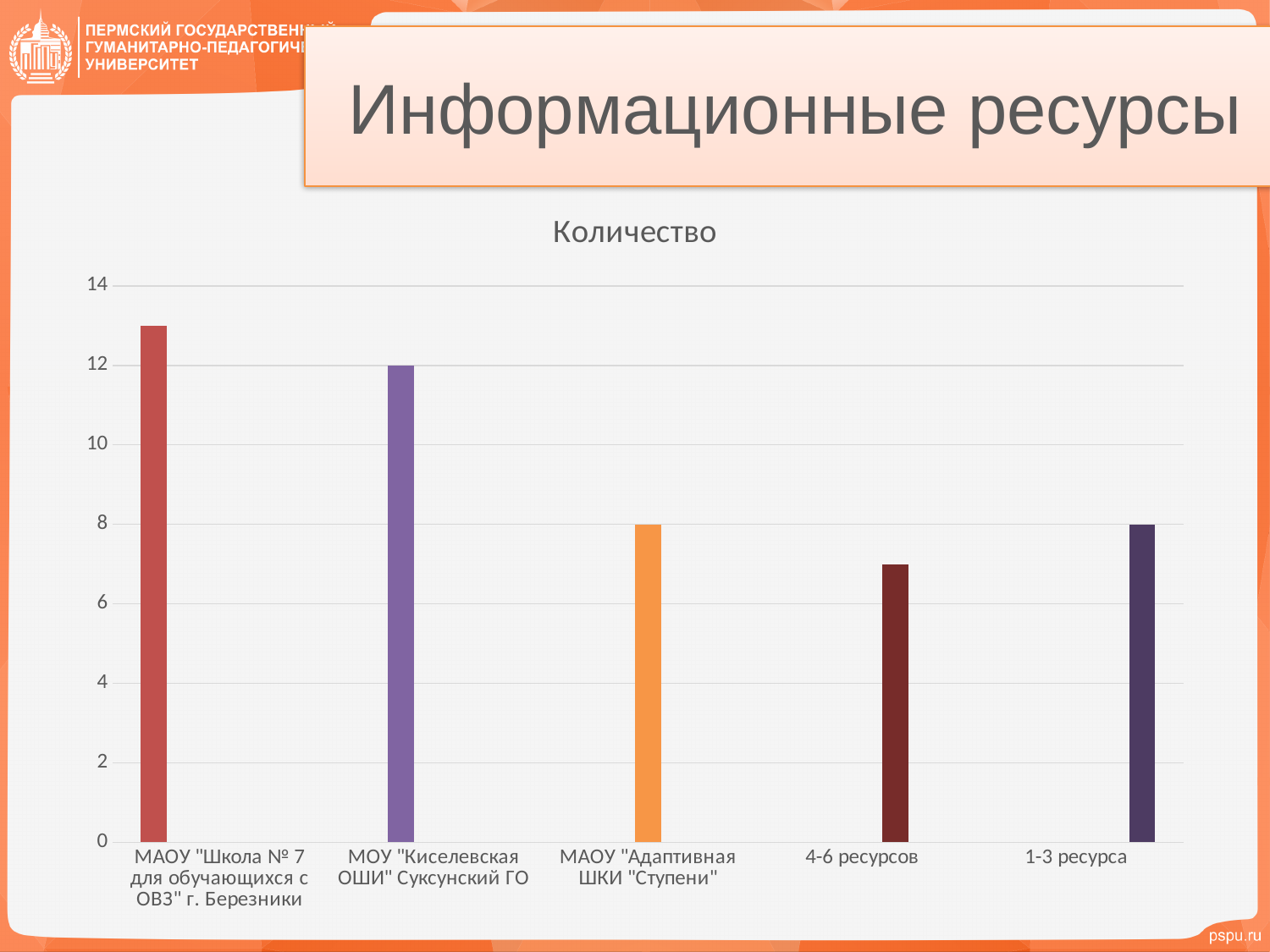
Which category has the lowest value? 4-6 ресурсов Is the value for 4-6 ресурсов greater or less than 8? less How many categories are shown on the x axis of the chart? 5 What is the difference between the values for МОУ "Киселевская ОШИ" Суксунский ГО and МАОУ "Адаптивная ШКИ "Ступени""? 4 What kind of chart is shown on the slide? bar chart What is the value for МАОУ "Адаптивная ШКИ "Ступени""? 8 Which category has the highest value? МАОУ "Школа № 7 для обучающихся с ОВЗ" г. Березники What is the title of the chart? Количество What is the value for 1-3 ресурса? 8 Is the value for МАОУ "Школа № 7 для обучающихся с ОВЗ" г. Березники greater or less than 12? greater What is the value for МОУ "Киселевская ОШИ" Суксунский ГО? 12 Which is larger, the value for МОУ "Киселевская ОШИ" Суксунский ГО or the value for 1-3 ресурса? МОУ "Киселевская ОШИ" Суксунский ГО